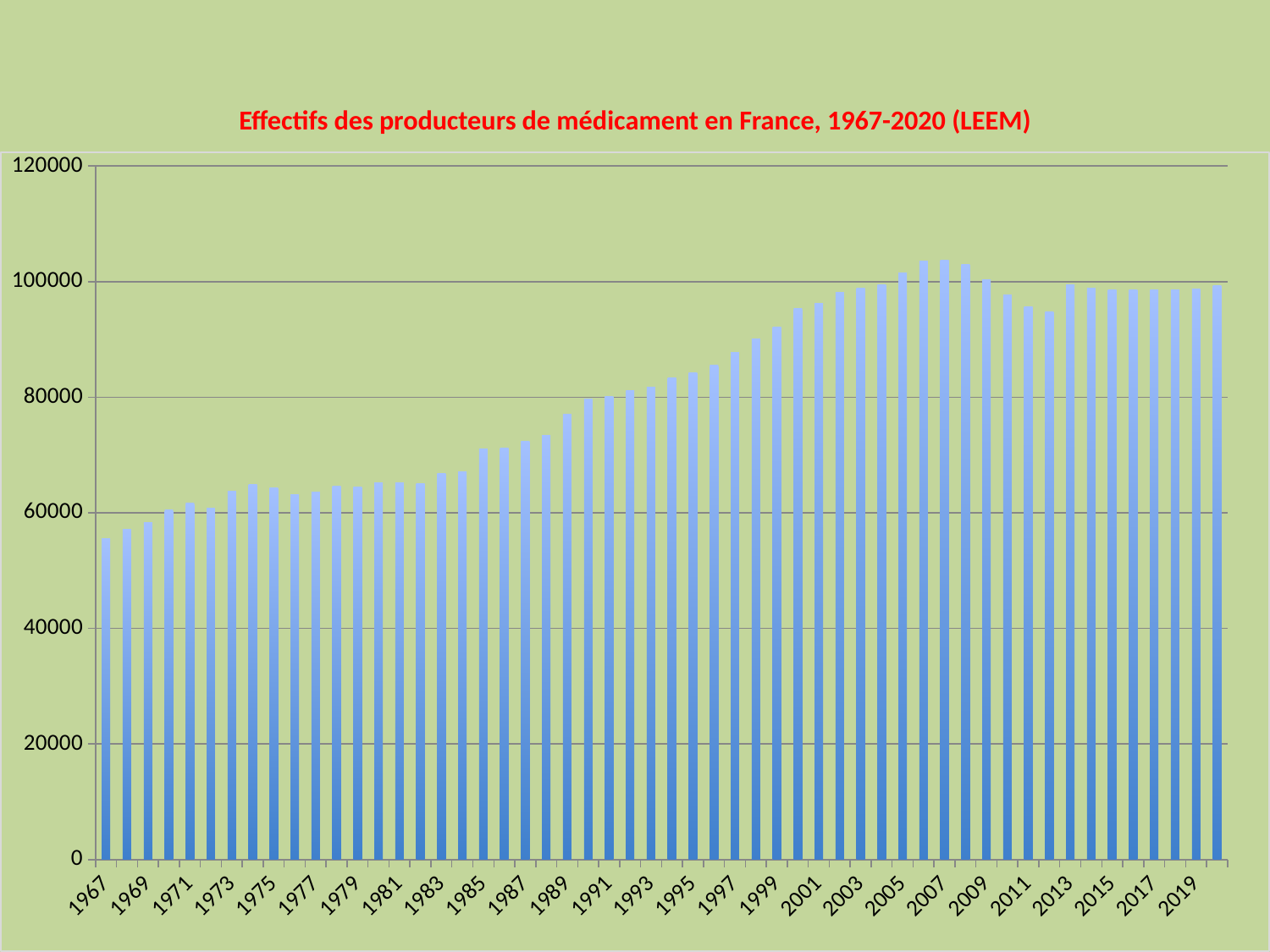
Do the values generally rise or fall from 1967 to 2007? rise Is the value for 2007 greater or less than 100000? greater Is the value for 2001 greater or less than 100000? less Which year has the lowest value in the chart? 1967 Is the value for 1985 greater or less than 60000? greater What is the highest value shown on the vertical axis? 120000 What is the title of the chart? Effectifs des producteurs de médicament en France, 1967-2020 (LEEM) Which is larger, the value for 2007 or the value for 1967? 2007 What kind of chart is shown on the slide? bar chart